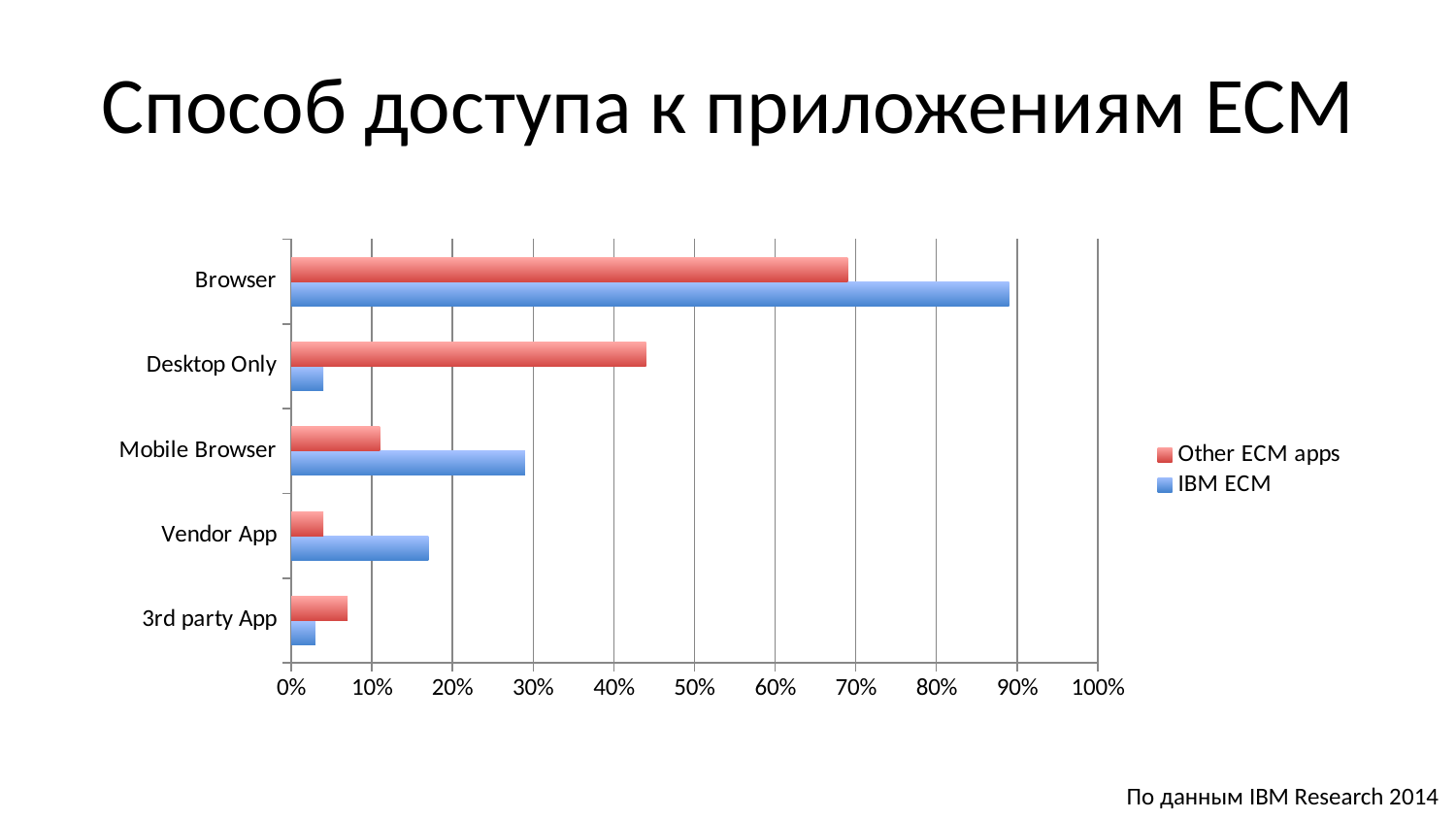
Is the IBM ECM value for Desktop Only greater or less than 10%? less What kind of chart is shown on the slide? bar chart Which category has the highest value for the Other ECM apps series? Browser How many categories are shown on the chart? 5 Is the IBM ECM value for Browser greater or less than 80%? greater For Desktop Only, which series has the larger value, IBM ECM or Other ECM apps? Other ECM apps Which category has the lowest value for the IBM ECM series? 3rd party App How many series does the legend list? 2 Which series is shown in blue in the legend? IBM ECM For Mobile Browser, which series has the larger value, IBM ECM or Other ECM apps? IBM ECM Which category has the highest value for the IBM ECM series? Browser Is the Other ECM apps value for Desktop Only greater or less than 40%? greater